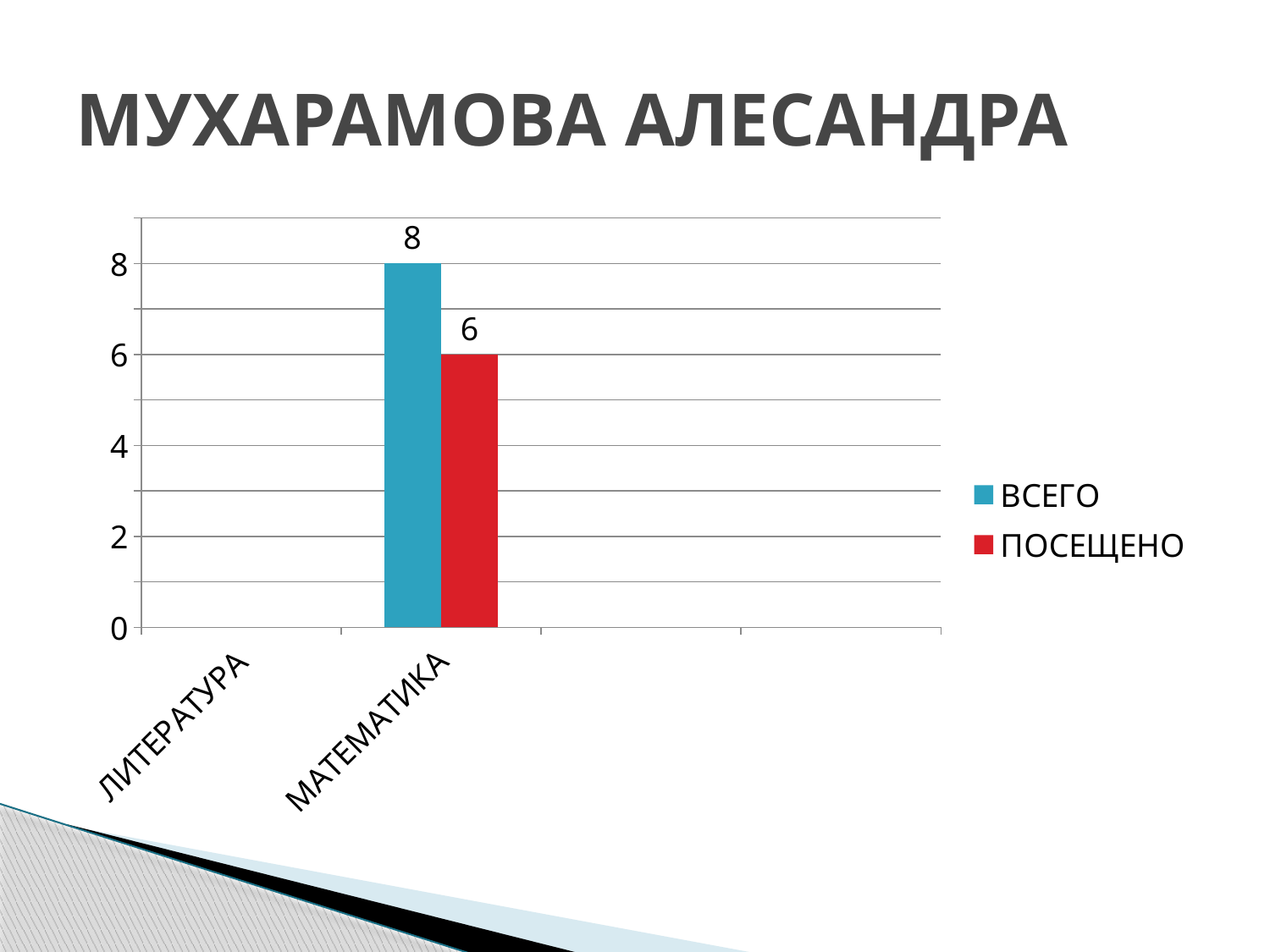
For МАТЕМАТИКА, which is larger: ВСЕГО or ПОСЕЩЕНО? ВСЕГО How many series does the legend list? 2 Is the ПОСЕЩЕНО value for МАТЕМАТИКА greater or less than 4? greater What is the value of ВСЕГО for МАТЕМАТИКА? 8 What kind of chart is shown on the slide? bar chart Which category has the highest ВСЕГО value? МАТЕМАТИКА What is the value of ПОСЕЩЕНО for МАТЕМАТИКА? 6 What is the difference between ВСЕГО and ПОСЕЩЕНО for МАТЕМАТИКА? 2 What colour represents the ПОСЕЩЕНО series? red What is the title of the slide? МУХАРАМОВА АЛЕСАНДРА How many categories have bars plotted in the chart? 1 Is the ВСЕГО value for МАТЕМАТИКА greater or less than 6? greater